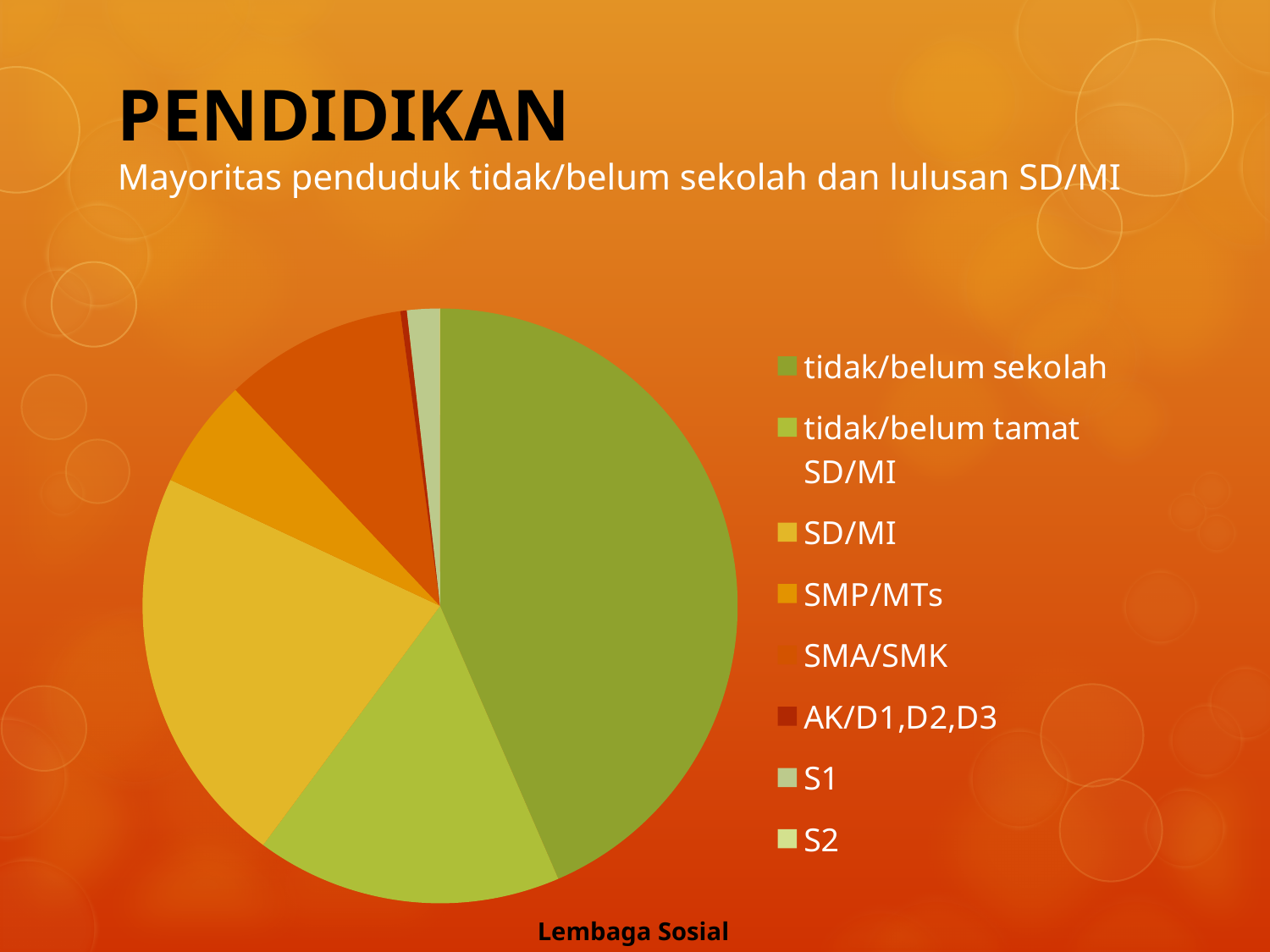
How many categories does the legend of the pie chart list? 8 Which is larger in the pie chart, the slice for tidak/belum tamat SD/MI or the slice for SMP/MTs? tidak/belum tamat SD/MI Which is larger in the pie chart, the slice for tidak/belum sekolah or the slice for tidak/belum tamat SD/MI? tidak/belum sekolah Which is larger in the pie chart, the slice for SMP/MTs or the slice for S1? SMP/MTs Which category is listed first in the pie chart's legend? tidak/belum sekolah Which category has the largest slice of the pie chart? tidak/belum sekolah What kind of chart is shown on the slide? pie chart Which category is listed last in the pie chart's legend? S2